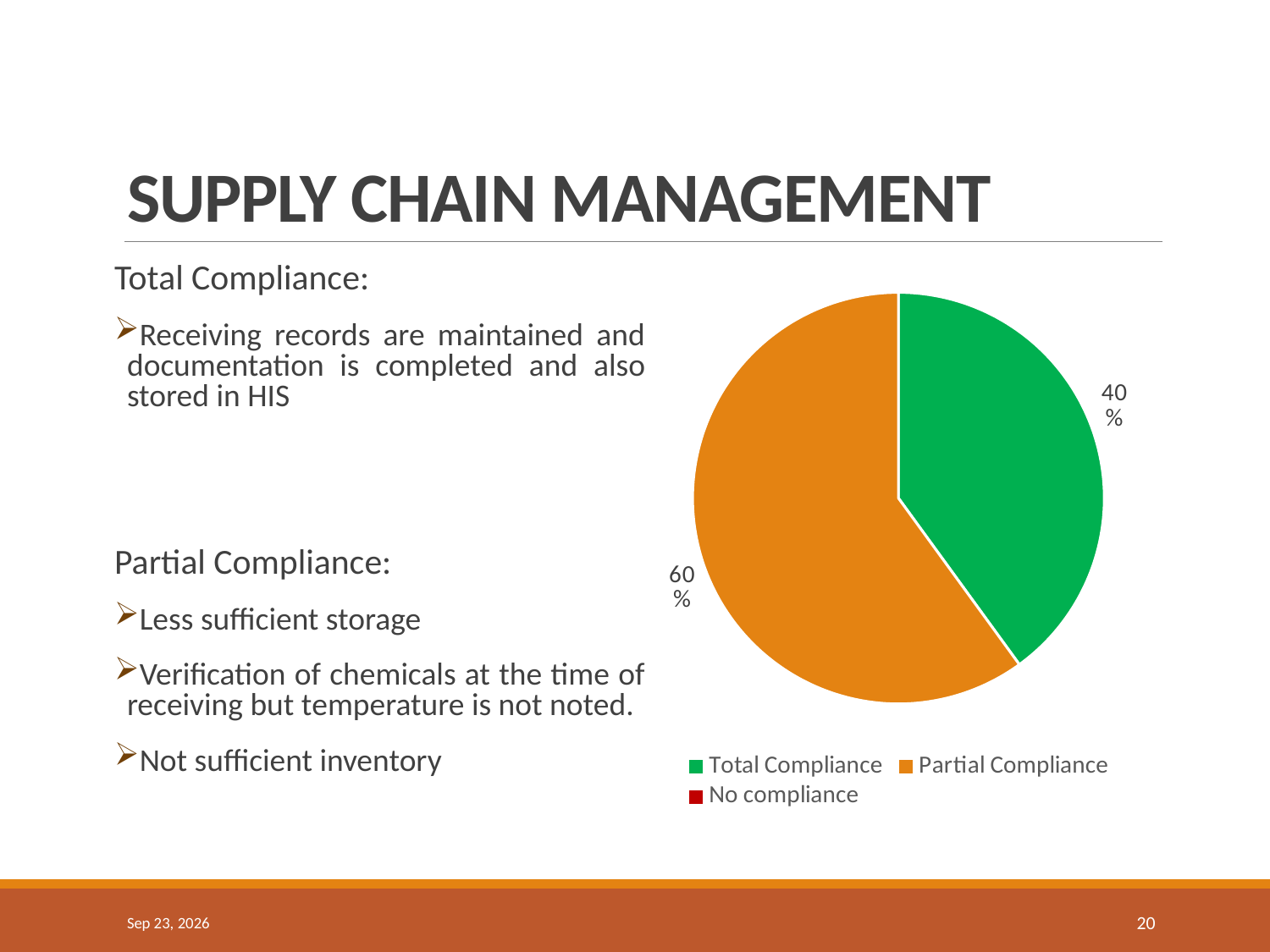
What kind of chart is shown on the slide? pie chart What colour is the Partial Compliance slice? orange How many slices are visible in the pie? 2 How many entries does the legend list? 3 What colour is the Total Compliance slice? green What percentage of the pie is Total Compliance? 40% Which is larger, Total Compliance or Partial Compliance? Partial Compliance What percentage of the pie is Partial Compliance? 60% Is the share for Total Compliance greater or less than 50%? less What is the difference in percentage points between Partial Compliance and Total Compliance? 20 Which category has the largest share of the pie? Partial Compliance